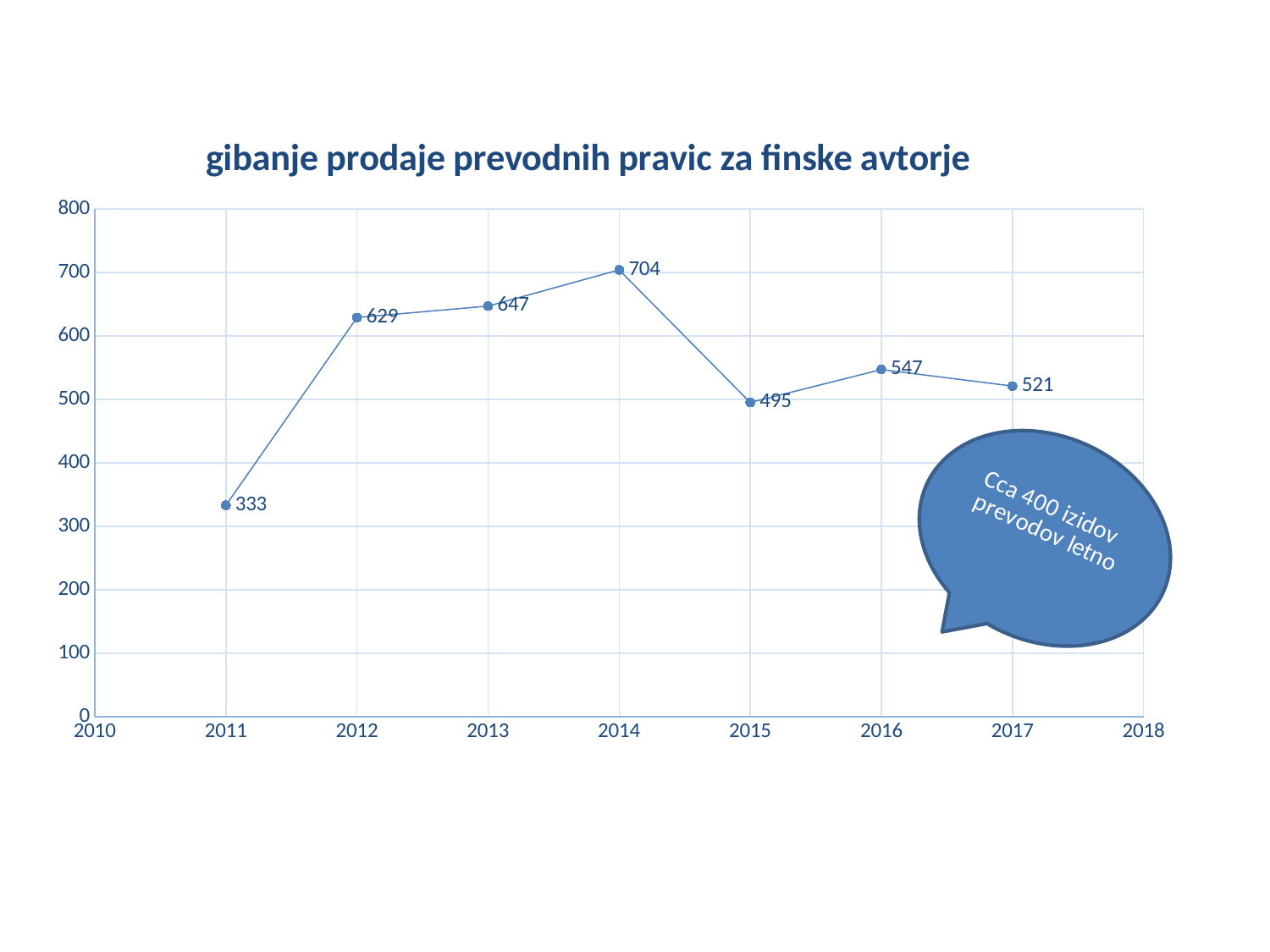
Which is larger, the value for 2016 or the value for 2017? 2016 What is the difference between the values for 2014 and 2015? 209 What is the value for 2014? 704 How many data points are plotted on the chart? 7 What is the difference between the values for 2012 and 2011? 296 Which year has the lowest value? 2011 Is the value for 2013 greater or less than 600? greater What is the value for 2017? 521 Which year has the highest value? 2014 What is the value for 2011? 333 What kind of chart is shown on the slide? line chart What is the title of the chart? gibanje prodaje prevodnih pravic za finske avtorje